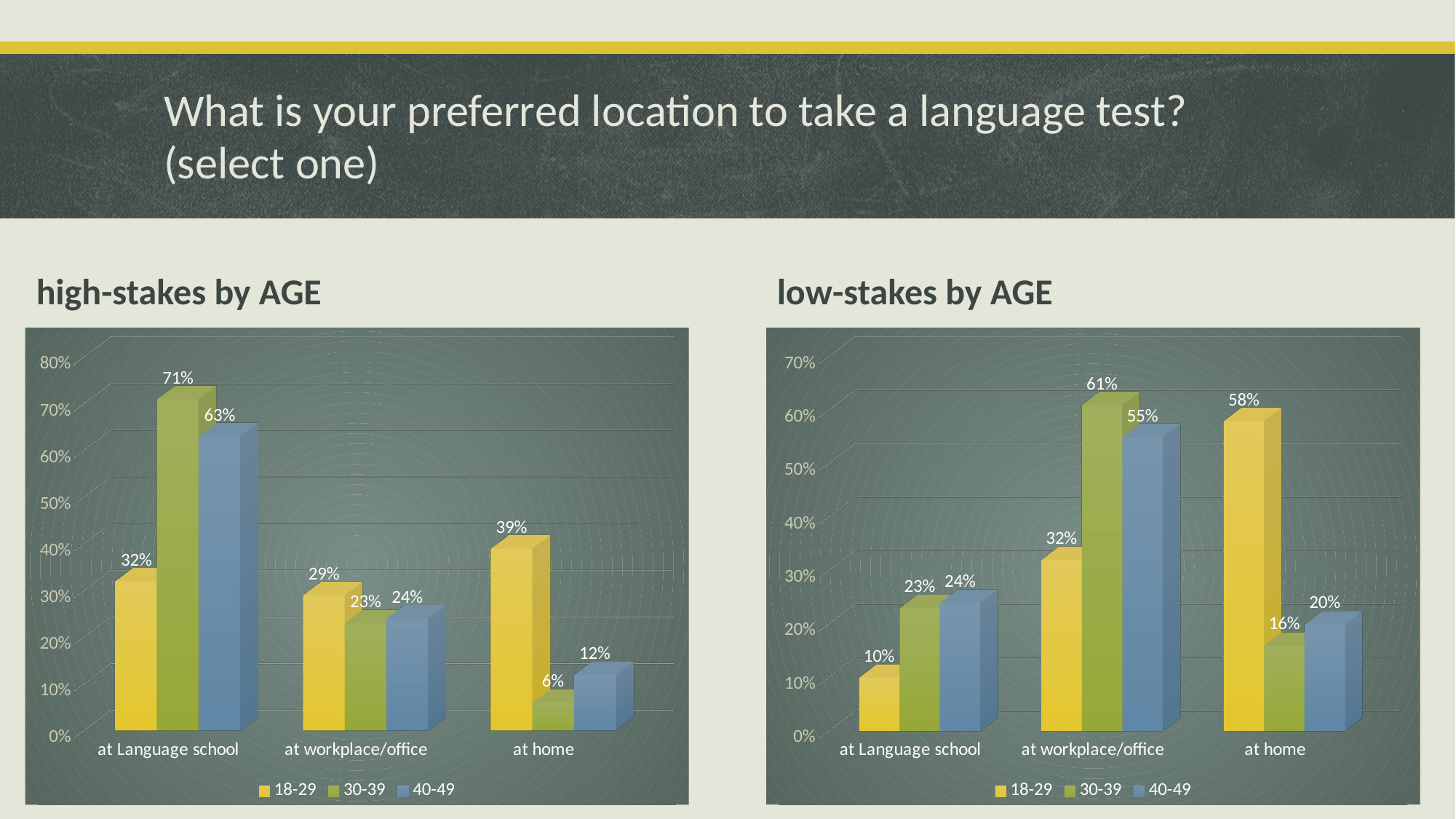
In the 'low-stakes by AGE' chart, is the 40-49 value at workplace/office greater or less than 50%? greater In the 'high-stakes by AGE' chart, what is the difference between the 30-39 and 40-49 values at Language school? 8% What kind of chart is the 'low-stakes by AGE' chart? bar chart In the 'low-stakes by AGE' chart, what is the value for the 18-29 group at home? 58% How many location categories are shown on the x axis of the 'high-stakes by AGE' chart? 3 In the 'high-stakes by AGE' chart, which is larger: the 18-29 value at workplace/office or the 18-29 value at home? at home In the 'high-stakes by AGE' chart, what is the value for the 40-49 group at workplace/office? 24% In the 'high-stakes by AGE' chart, which age group has the lowest value at home? 30-39 In the 'low-stakes by AGE' chart, which age group has the highest value at workplace/office? 30-39 In the 'high-stakes by AGE' chart, what is the value for the 30-39 group at Language school? 71% How many series does the legend of the 'low-stakes by AGE' chart list? 3 In the 'low-stakes by AGE' chart, what is the difference between the 18-29 and 30-39 values at home? 42%